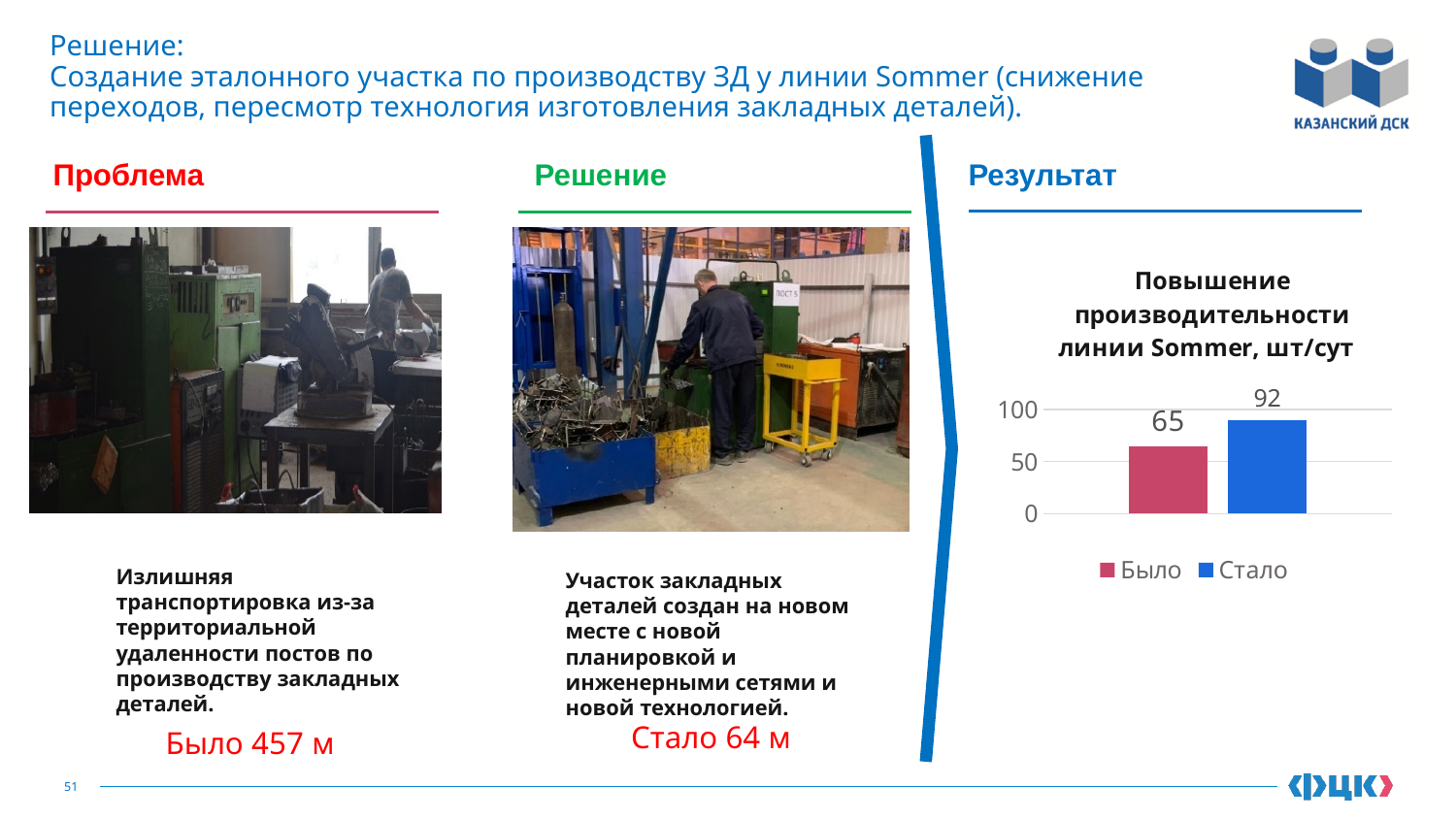
How many series does the legend list? 2 What is the value for "Стало" in the chart? 92 What is the value for "Было" in the chart? 65 Which series has the highest value in the chart? Стало What is the difference between the "Стало" and "Было" values? 27 Which series has the lowest value in the chart? Было Which series has the higher value, "Было" or "Стало"? Стало What kind of chart is shown on the slide? bar chart What is the title of the chart? Повышение производительности линии Sommer, шт/сут Is the value for "Стало" greater or less than 50? greater Is the value for "Было" greater or less than 100? less What colour is the bar for "Стало"? blue